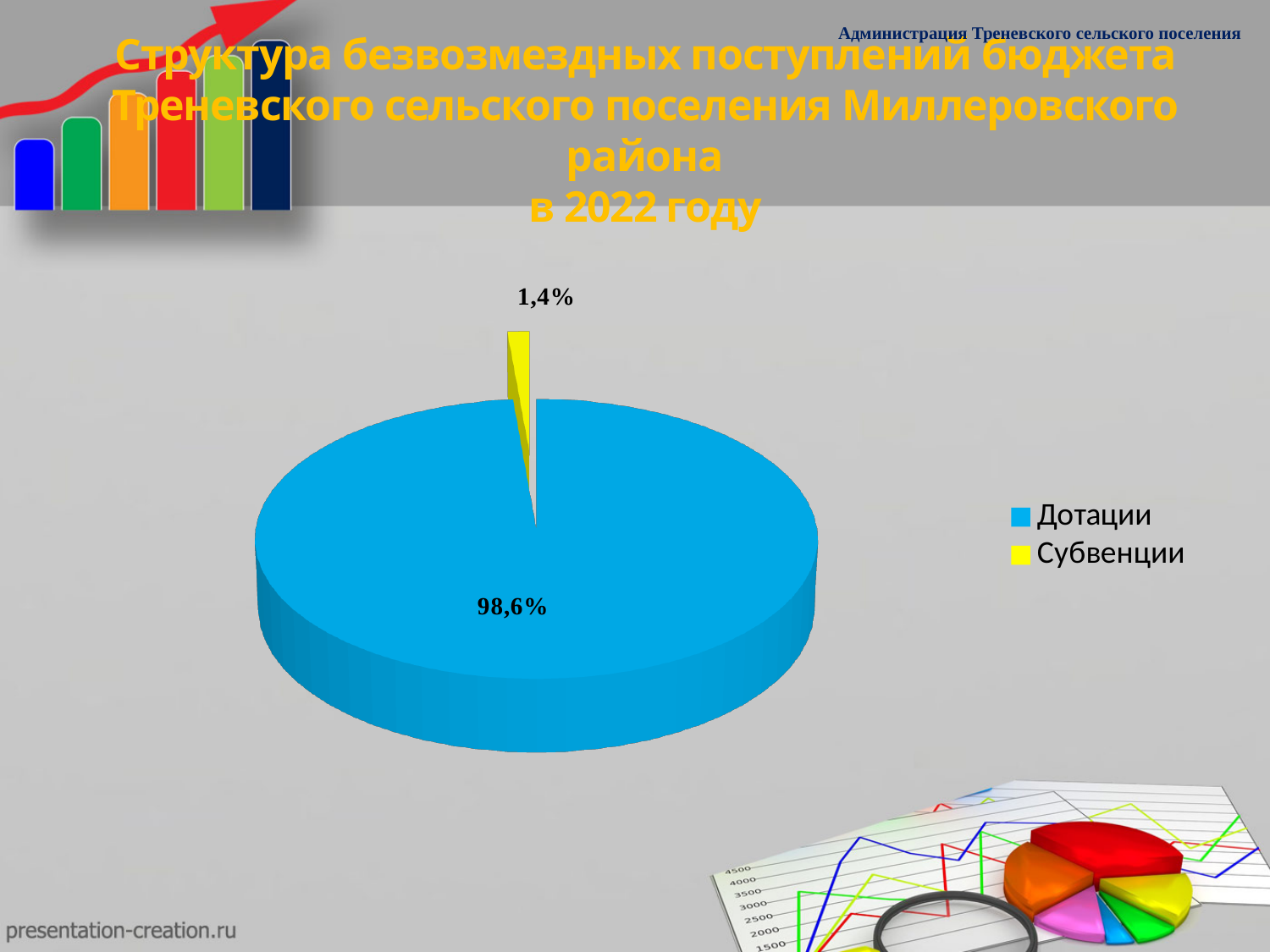
Which is larger, the share for Дотации or the share for Субвенции? Дотации What share of the pie does Дотации have? 98,6% How many entries does the legend list? 2 What colour is the Субвенции slice? yellow Which category has the largest slice of the pie? Дотации What is the difference in percentage points between the Дотации share and the Субвенции share? 97,2 What kind of chart is shown on the slide? pie chart What share of the pie does Субвенции have? 1,4% How many slices does the pie chart have? 2 What colour is the Дотации slice? blue Which category has the smallest slice of the pie? Субвенции